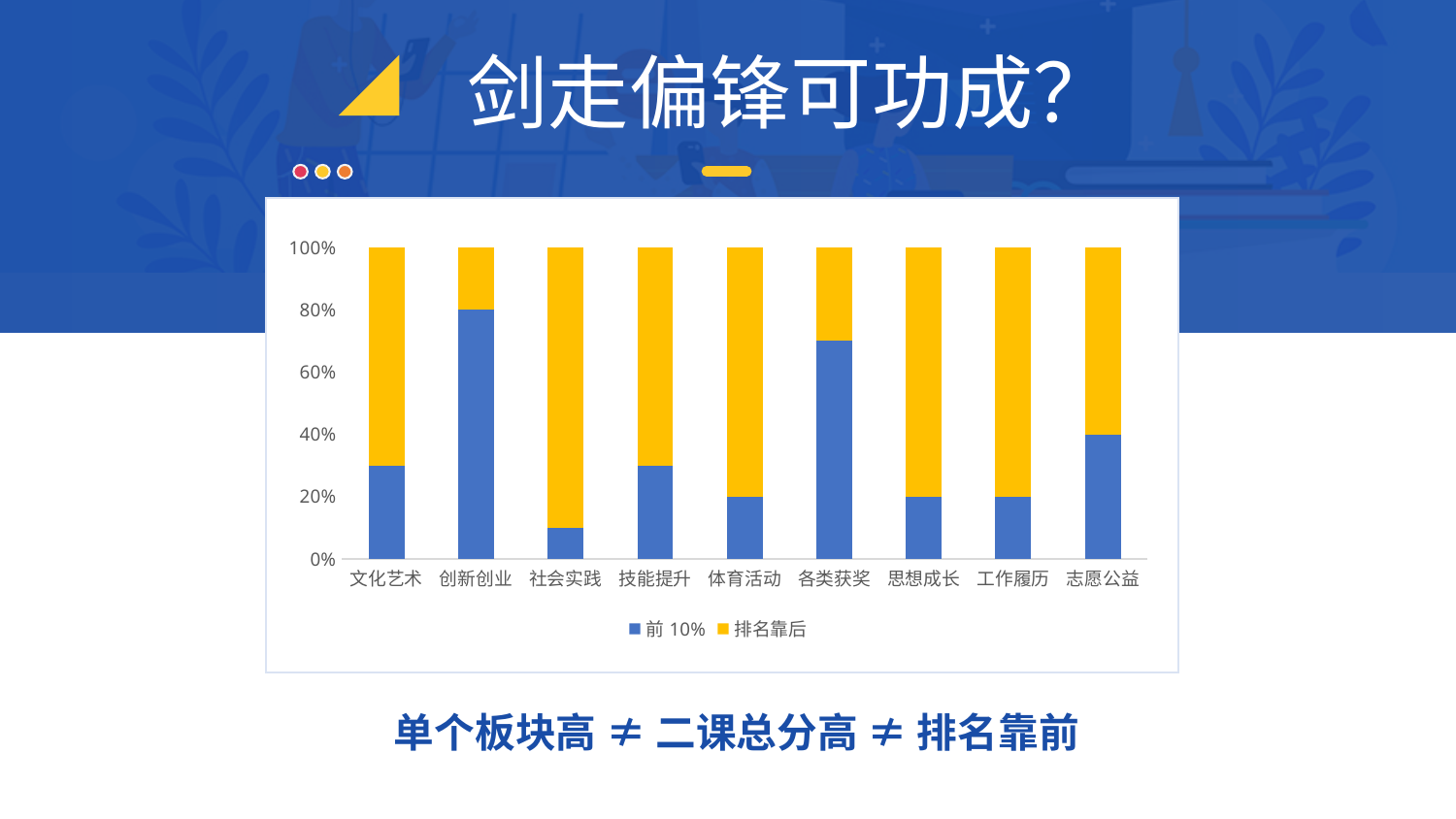
Which category has the highest value for 前 10%? 创新创业 Is the value for 前 10% in the 社会实践 category greater or less than 20%? less Is the value for 前 10% in the 各类获奖 category greater or less than 60%? greater What are the two series named in the legend? 前 10% and 排名靠后 What is the value for 前 10% in the 创新创业 category? 80% Which category has the lowest value for 前 10%? 社会实践 How many series does the chart's legend list? 2 What is the value for 前 10% in the 志愿公益 category? 40% What kind of chart is shown on the slide? bar chart How many categories are shown on the x axis of the chart? 9 Which is larger, the 前 10% value for 各类获奖 or for 文化艺术? 各类获奖 What is the value for 前 10% in the 体育活动 category? 20%